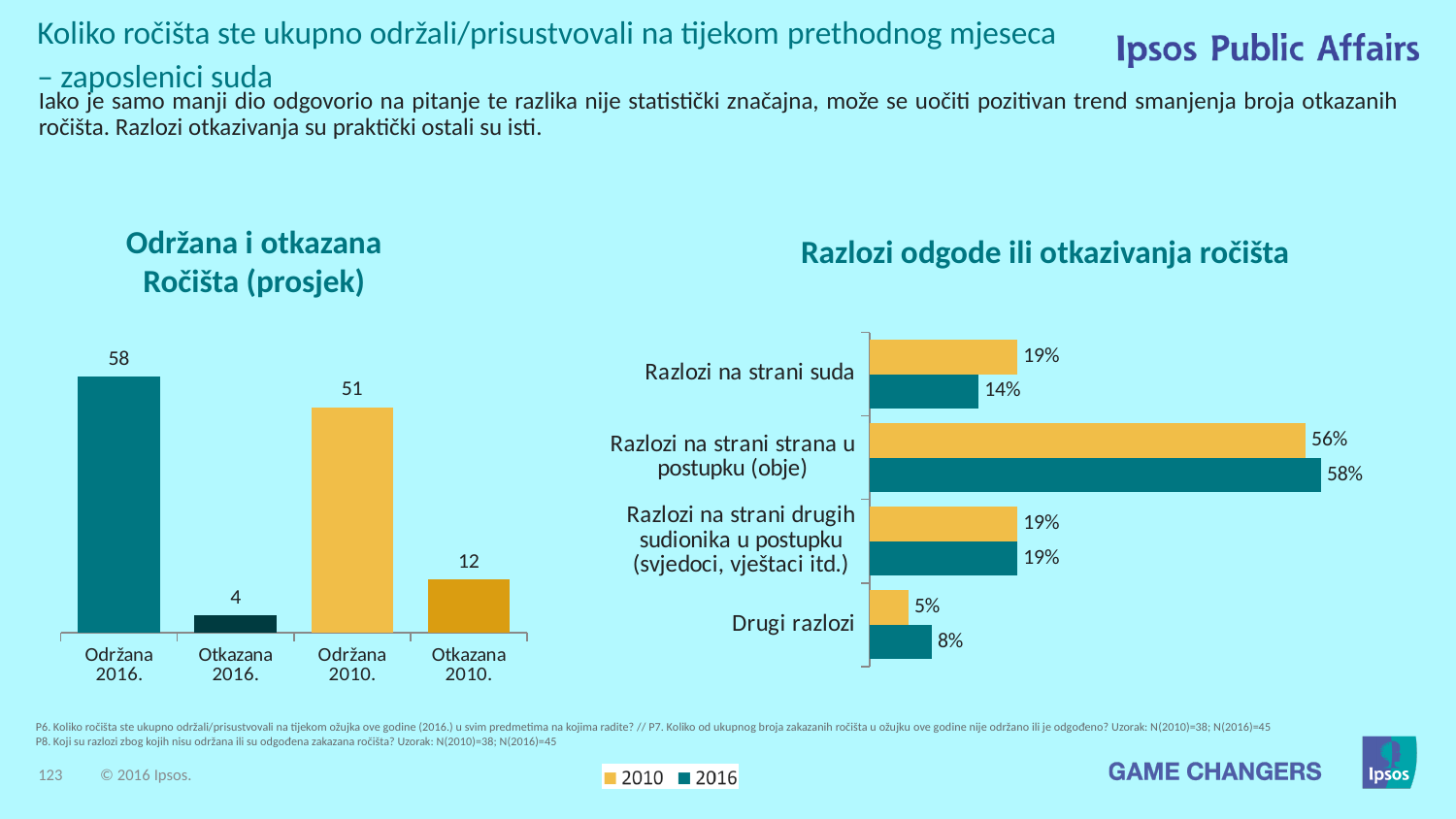
In the chart 'Razlozi odgode ili otkazivanja ročišta', is the 2010 value for Razlozi na strani suda larger or smaller than the 2016 value? Larger In the chart 'Razlozi odgode ili otkazivanja ročišta', what is the 2016 value for Razlozi na strani suda? 14% In the chart 'Održana i otkazana Ročišta (prosjek)', what is the value for Održana 2016.? 58 What kind of chart is 'Razlozi odgode ili otkazivanja ročišta'? Bar chart In the chart 'Održana i otkazana Ročišta (prosjek)', what is the value for Otkazana 2010.? 12 In the chart 'Održana i otkazana Ročišta (prosjek)', which category has the lowest value? Otkazana 2016. In the chart 'Razlozi odgode ili otkazivanja ročišta', what is the difference between the 2016 and 2010 values for Drugi razlozi? 3% In the chart 'Održana i otkazana Ročišta (prosjek)', what is the difference between Održana 2016. and Održana 2010.? 7 In the chart 'Razlozi odgode ili otkazivanja ročišta', which category has the highest 2016 value? Razlozi na strani strana u postupku (obje) How many series does the legend at the bottom of the slide list? 2 In the chart 'Održana i otkazana Ročišta (prosjek)', how many bars are shown? 4 In the chart 'Razlozi odgode ili otkazivanja ročišta', what is the 2010 value for Drugi razlozi? 5%